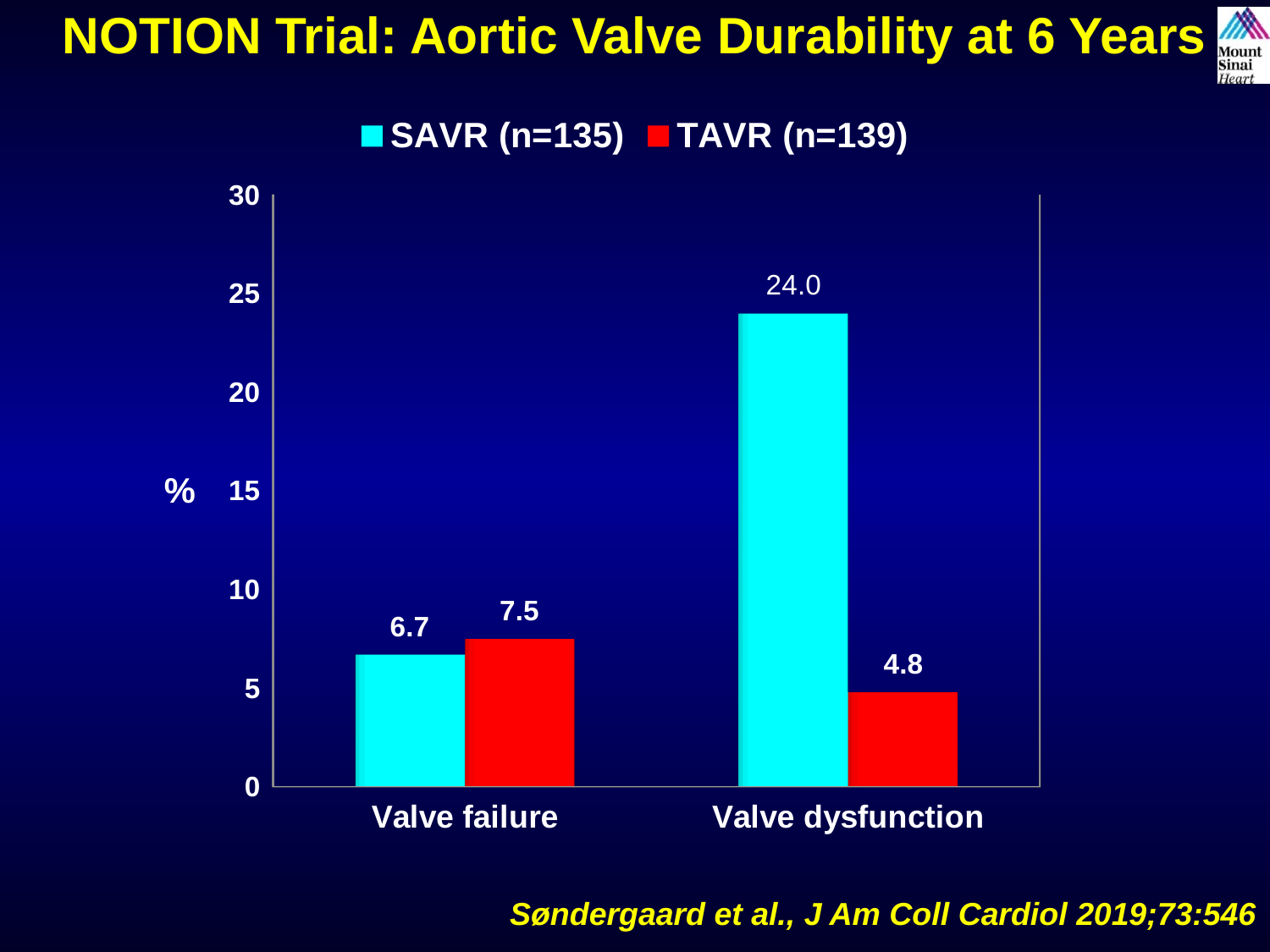
Which bar has the lowest value on the chart? TAVR, Valve dysfunction Is the SAVR value for Valve dysfunction greater or less than 20? greater How many categories are shown on the x axis? 2 What is the SAVR value for Valve failure? 6.7 How many series does the legend list? 2 What is the TAVR value for Valve dysfunction? 4.8 What kind of chart is shown on the slide? Bar chart Which bar has the highest value on the chart? SAVR, Valve dysfunction For Valve failure, which is larger: SAVR or TAVR? TAVR What is the SAVR value for Valve dysfunction? 24.0 What is the difference between the SAVR and TAVR values for Valve dysfunction? 19.2 What is the TAVR value for Valve failure? 7.5